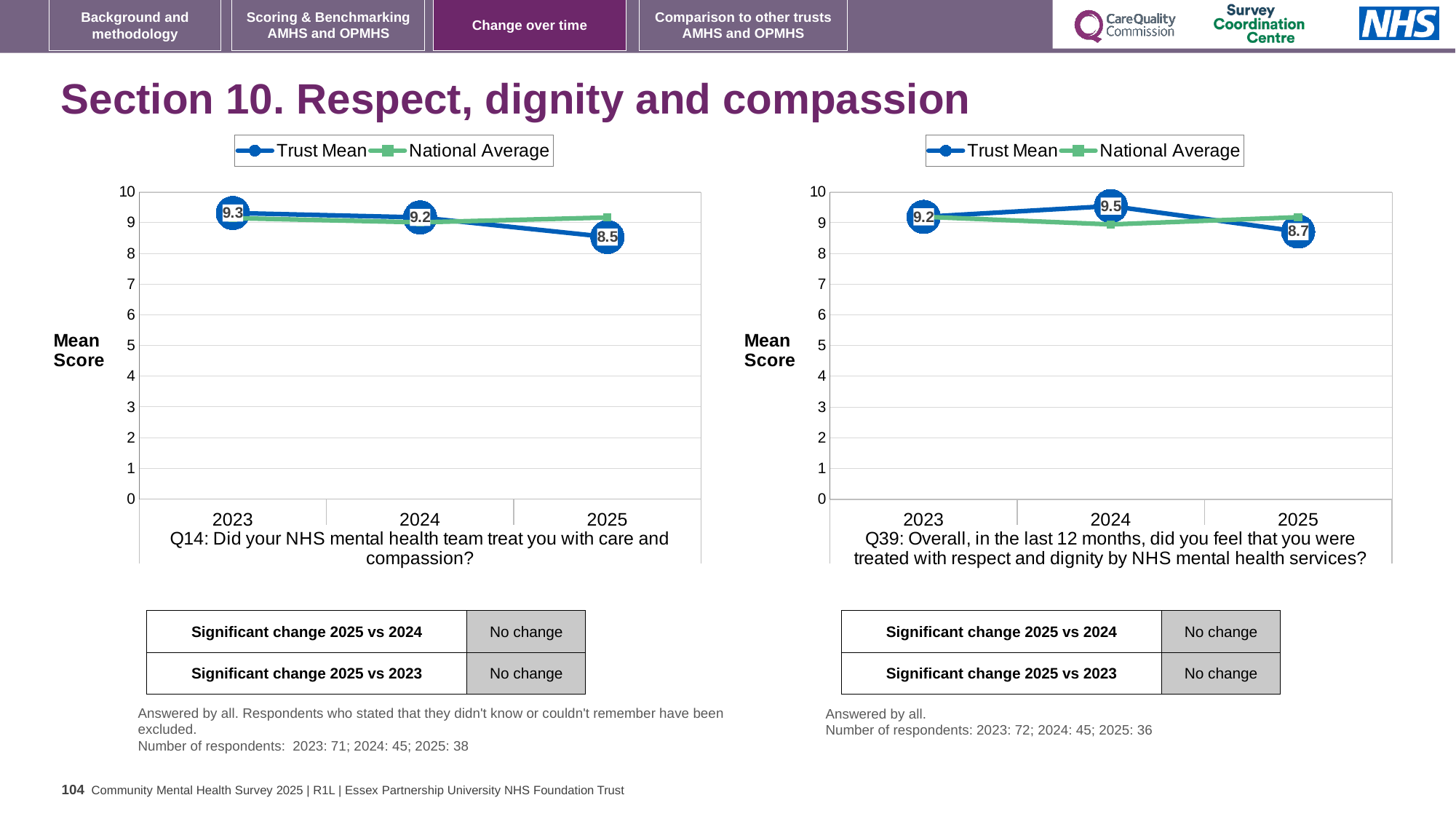
In the Q14 chart (left), what is the difference between the Trust Mean in 2023 and in 2025? 0.8 In the Q39 chart (right), what is the difference between the Trust Mean in 2024 and in 2025? 0.8 In the Q14 chart (left), what is the Trust Mean for 2025? 8.5 What kind of chart is the Q39 chart (right)? Line chart In the Q39 chart (right), is the Trust Mean for 2023 or for 2024 larger? 2024 In the Q39 chart (right), what is the Trust Mean for 2025? 8.7 In the Q39 chart (right), what is the Trust Mean for 2024? 9.5 In the Q14 chart (left), which year has the lowest Trust Mean? 2025 In the Q14 chart (left), is the National Average for 2025 greater or less than 8? greater In the Q14 chart (left), what is the Trust Mean for 2023? 9.3 In the Q39 chart (right), which year has the highest Trust Mean? 2024 How many series does the legend of the Q14 chart (left) list? 2